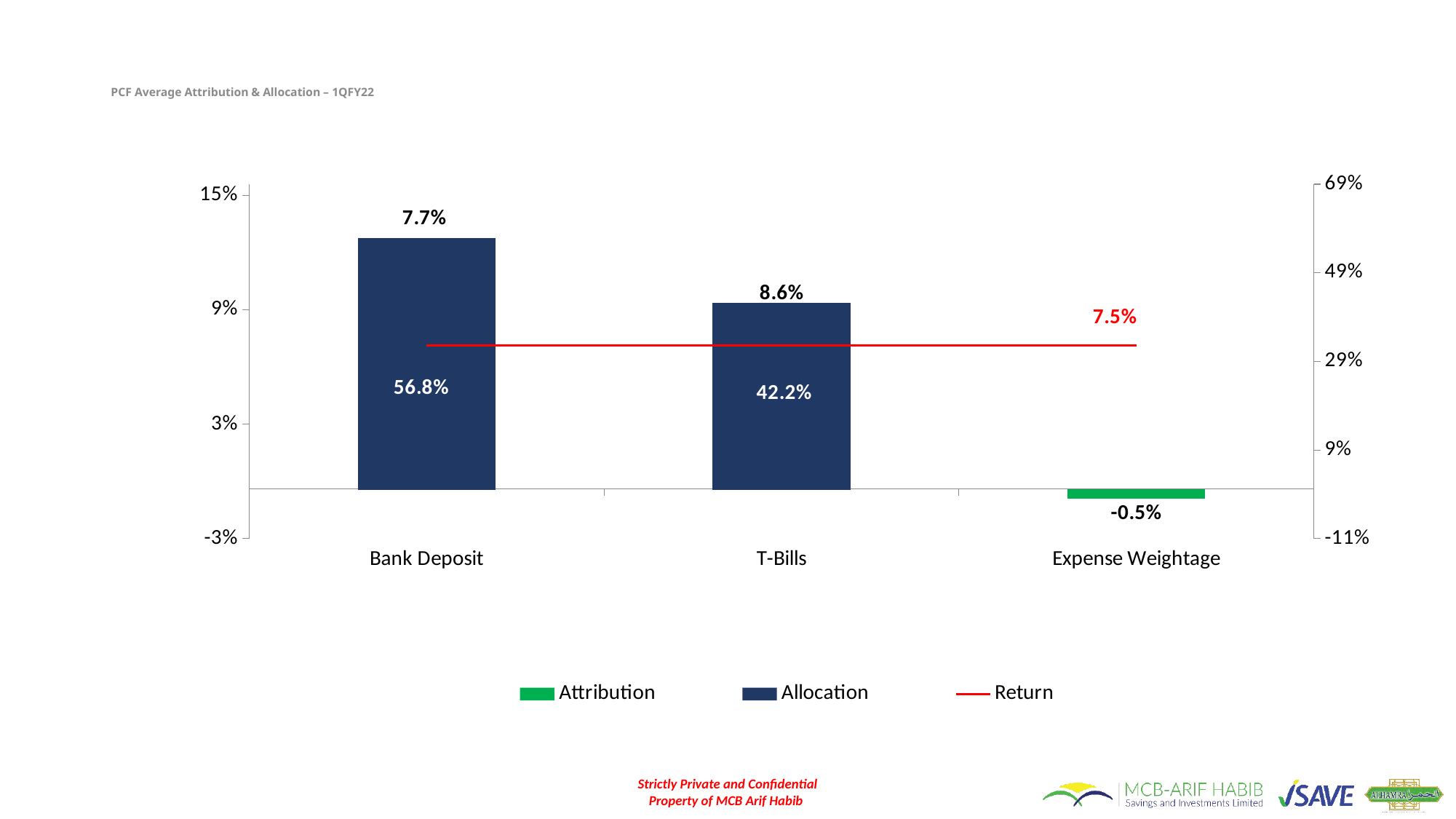
What value is printed above the Bank Deposit bar? 7.7% Which category has the higher Allocation, Bank Deposit or T-Bills? Bank Deposit What colour is the Attribution series in the legend? Green What value is printed above the T-Bills bar? 8.6% How many categories are shown on the x axis? 3 How many series does the legend list? 3 What is the Allocation value for T-Bills? 42.2% What is the title of the chart? PCF Average Attribution & Allocation – 1QFY22 What is the difference between the Allocation values for Bank Deposit and T-Bills? 14.6% What is the Return value shown on the chart? 7.5% What is the Allocation value for Bank Deposit? 56.8% What is the Attribution value for Expense Weightage? -0.5%